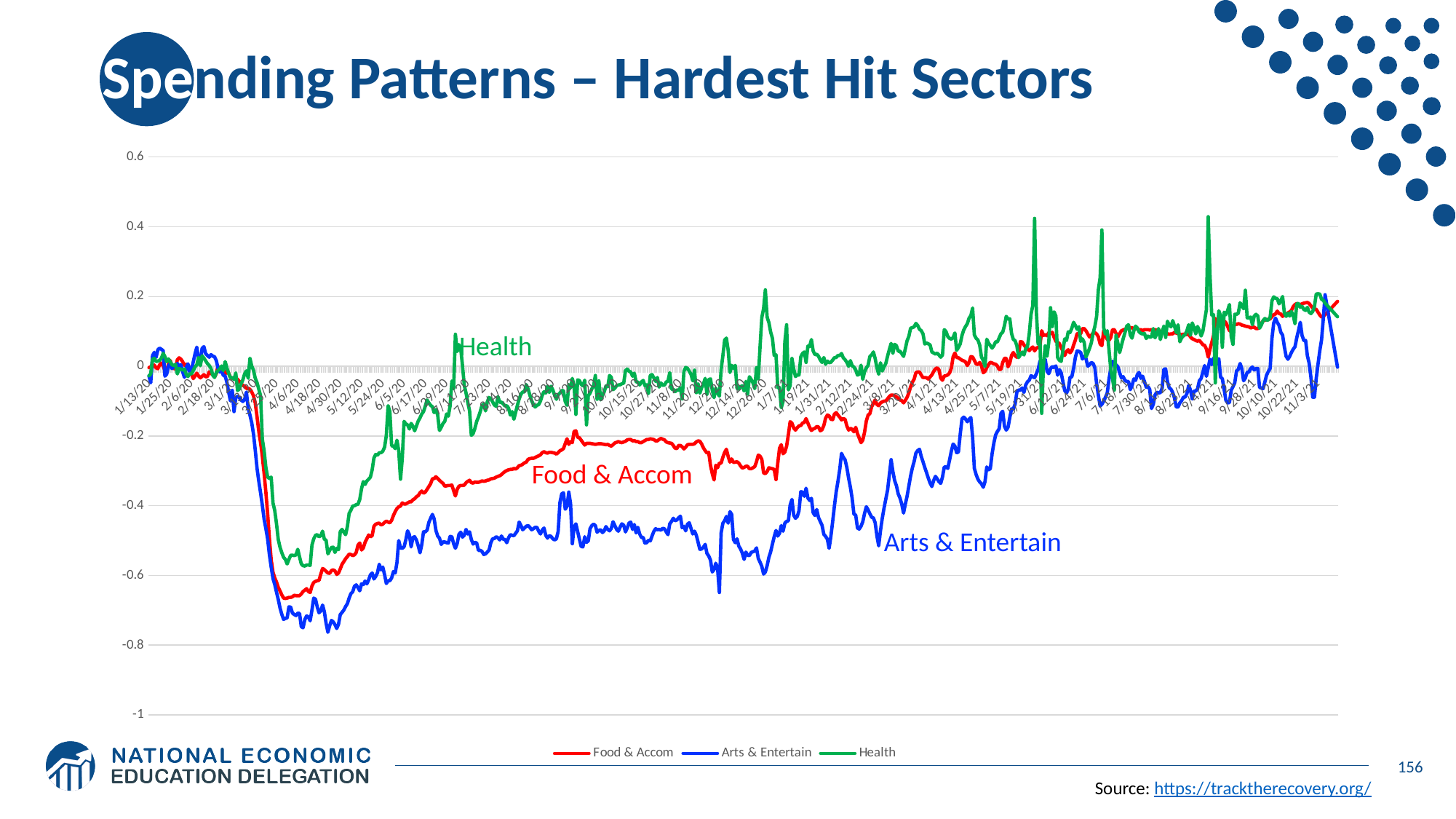
How many series does the legend list? 3 Which series reaches the lowest value on the chart? Arts & Entertain Is the lowest value of the Arts & Entertain series greater or less than -0.6? less What is the title of the slide's chart? Spending Patterns – Hardest Hit Sectors Which colour is used for the Health series? green From 4/6/20 to 11/3/21, does the Arts & Entertain series overall rise or fall? rise What kind of chart is shown on the slide? line chart Around 6/29/20, which of the three series is the highest? Health Is the lowest value of the Health series greater or less than -0.4? less Is the highest value of the Health series greater or less than 0.2? greater Around 10/15/20, which series is higher: Food & Accom or Arts & Entertain? Food & Accom